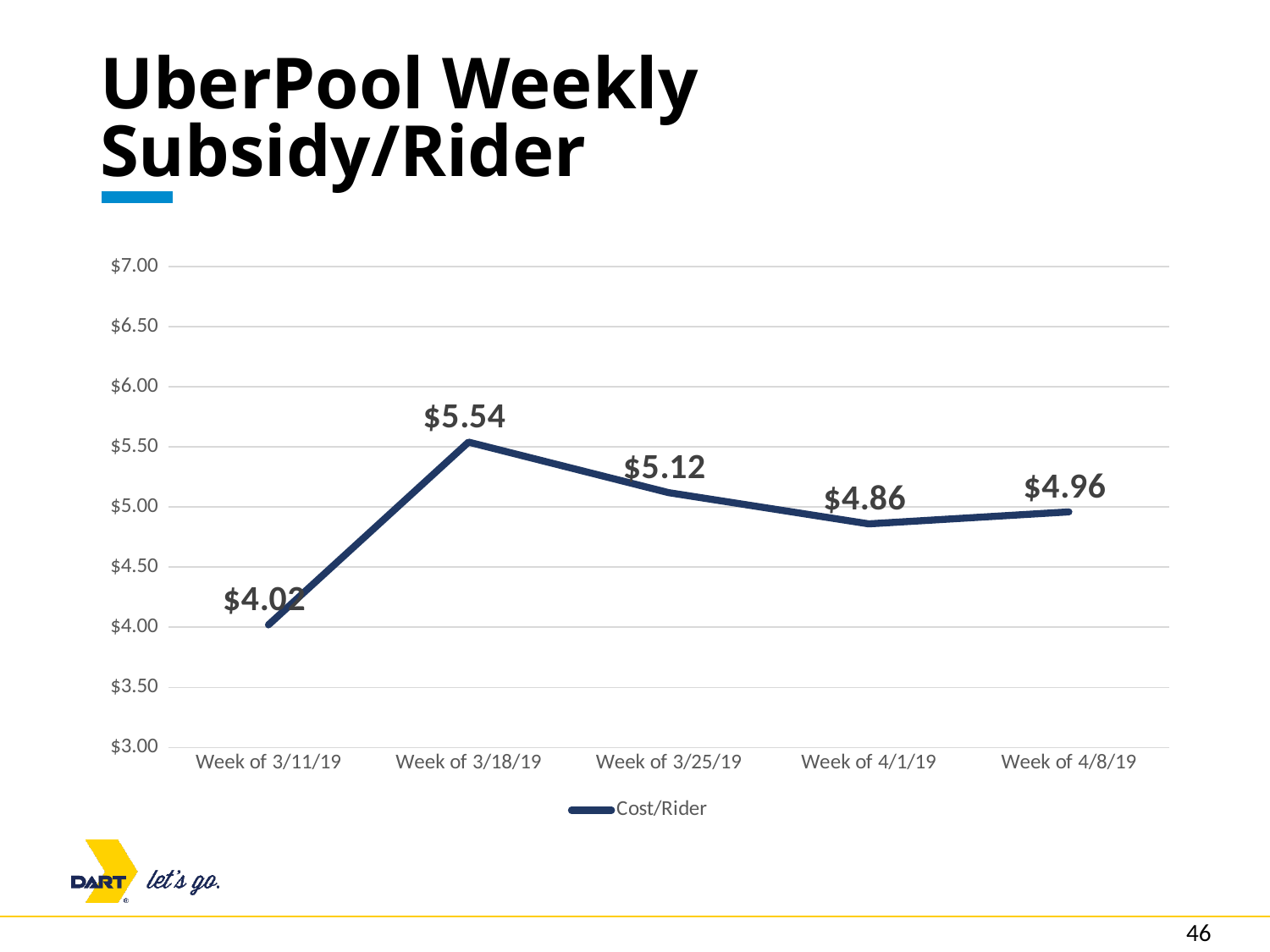
What is the Cost/Rider for the Week of 3/18/19? $5.54 What kind of chart is shown on the slide? line chart How many series does the legend list? 1 Which week has a higher Cost/Rider, the Week of 4/1/19 or the Week of 4/8/19? Week of 4/8/19 Which week has the highest Cost/Rider? Week of 3/18/19 What is the Cost/Rider for the Week of 3/11/19? $4.02 How many weeks are plotted on the chart? 5 Is the Cost/Rider for the Week of 3/25/19 greater or less than $5.00? greater Which week has the lowest Cost/Rider? Week of 3/11/19 Does the Cost/Rider rise or fall from the Week of 3/18/19 to the Week of 4/1/19? fall What is the difference in Cost/Rider between the Week of 3/18/19 and the Week of 3/25/19? $0.42 What is the Cost/Rider for the Week of 4/1/19? $4.86